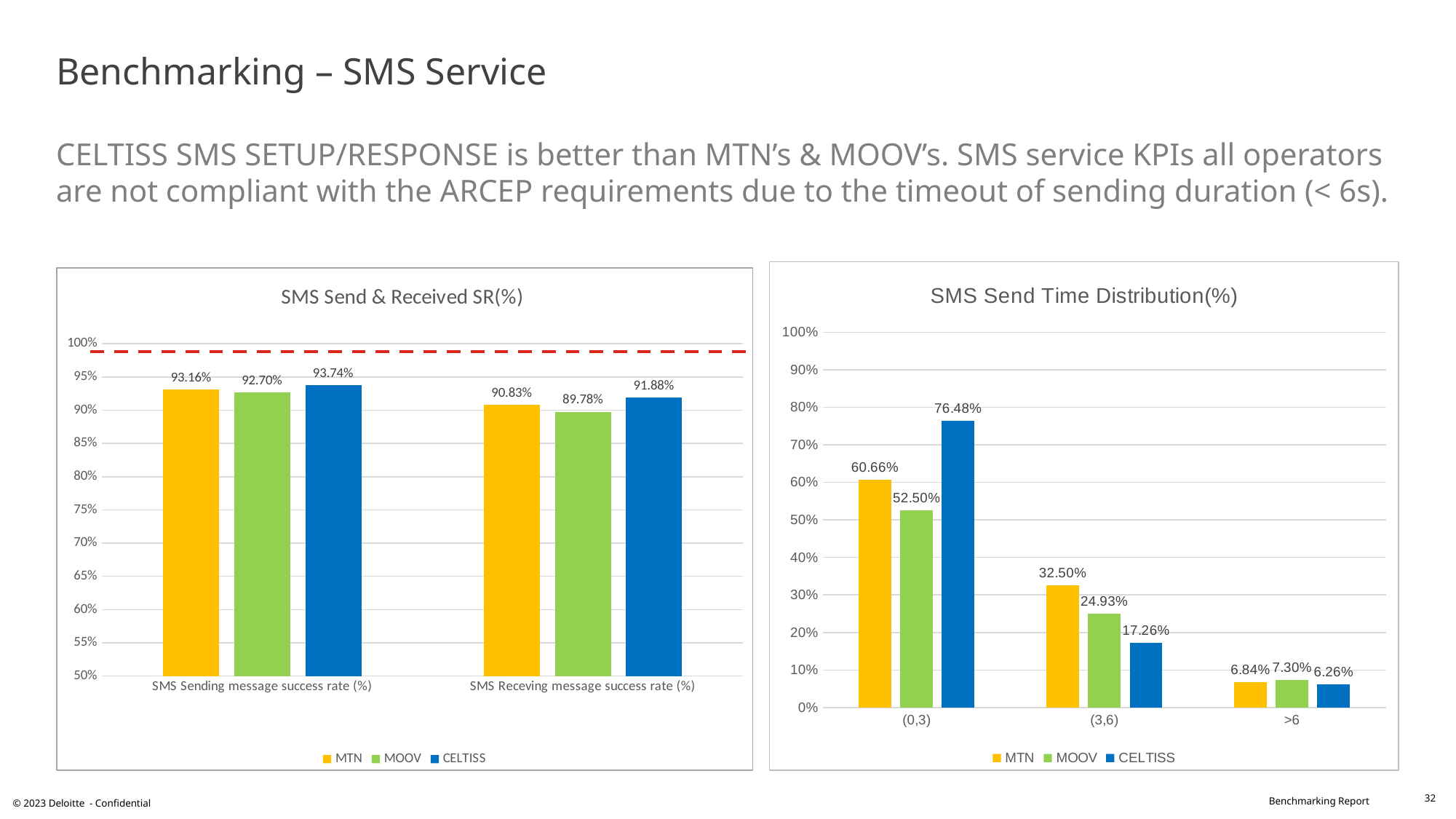
In the 'SMS Send Time Distribution(%)' chart, how many categories are shown on the x axis? 3 In the 'SMS Send & Received SR(%)' chart, how many series does the legend list? 3 In the 'SMS Send Time Distribution(%)' chart, what is the value for MOOV in the (3,6) category? 24.93% In the 'SMS Send & Received SR(%)' chart, what is the difference between CELTISS and MTN for SMS Receving message success rate (%)? 1.05% In the 'SMS Send & Received SR(%)' chart, what is the value for MOOV for SMS Receving message success rate (%)? 89.78% In the 'SMS Send Time Distribution(%)' chart, what is the value for CELTISS in the (0,3) category? 76.48% In the 'SMS Send Time Distribution(%)' chart, what is the difference between MTN and CELTISS in the (3,6) category? 15.24% What kind of chart is 'SMS Send Time Distribution(%)'? bar chart In the 'SMS Send Time Distribution(%)' chart, do the MTN values rise or fall from (0,3) to >6? fall In the 'SMS Send & Received SR(%)' chart, which operator has the lowest SMS Sending message success rate (%)? MOOV In the 'SMS Send & Received SR(%)' chart, what is the value for CELTISS for SMS Sending message success rate (%)? 93.74% In the 'SMS Send Time Distribution(%)' chart, which operator has the highest value in the >6 category? MOOV